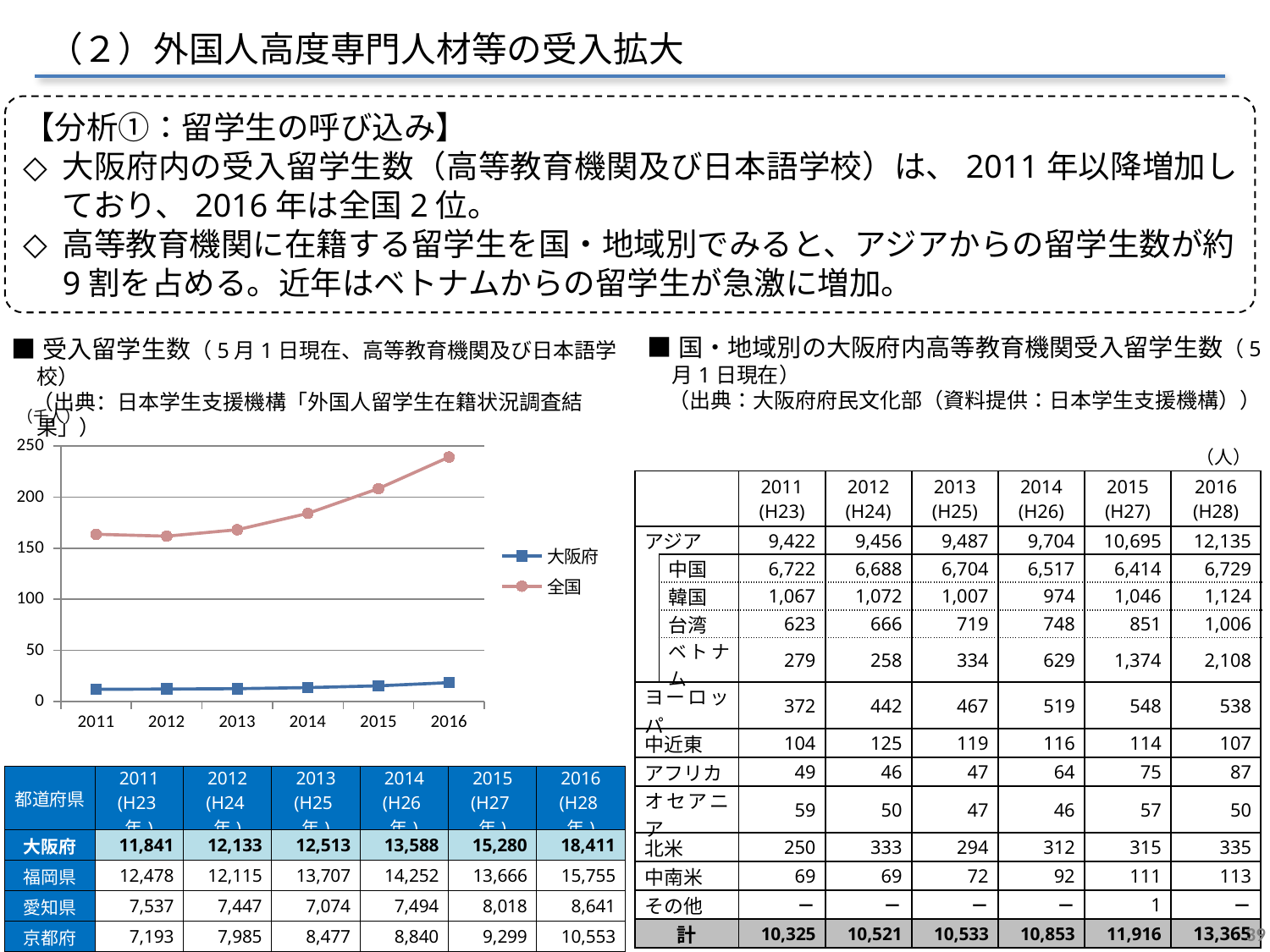
In the 受入留学生数 line chart, is the value for 全国 in 2011 greater or less than 150? greater What kind of chart is shown on the left side of the slide under 受入留学生数? line chart In the 受入留学生数 line chart, does the 全国 series rise or fall from 2012 to 2016? rise In the 受入留学生数 line chart, is the value for 全国 in 2014 greater or less than 200? less In the 受入留学生数 line chart, which series has the larger value in 2016, 大阪府 or 全国? 全国 What are the two series named in the legend of the 受入留学生数 line chart? 大阪府 and 全国 In the 受入留学生数 line chart, is the value for 全国 in 2016 greater or less than 200? greater How many years are plotted along the x axis of the 受入留学生数 line chart? 6 What unit is shown on the y axis of the 受入留学生数 line chart? 千人 How many series does the legend of the 受入留学生数 line chart list? 2 In the 受入留学生数 line chart, which year has the highest value for 全国? 2016